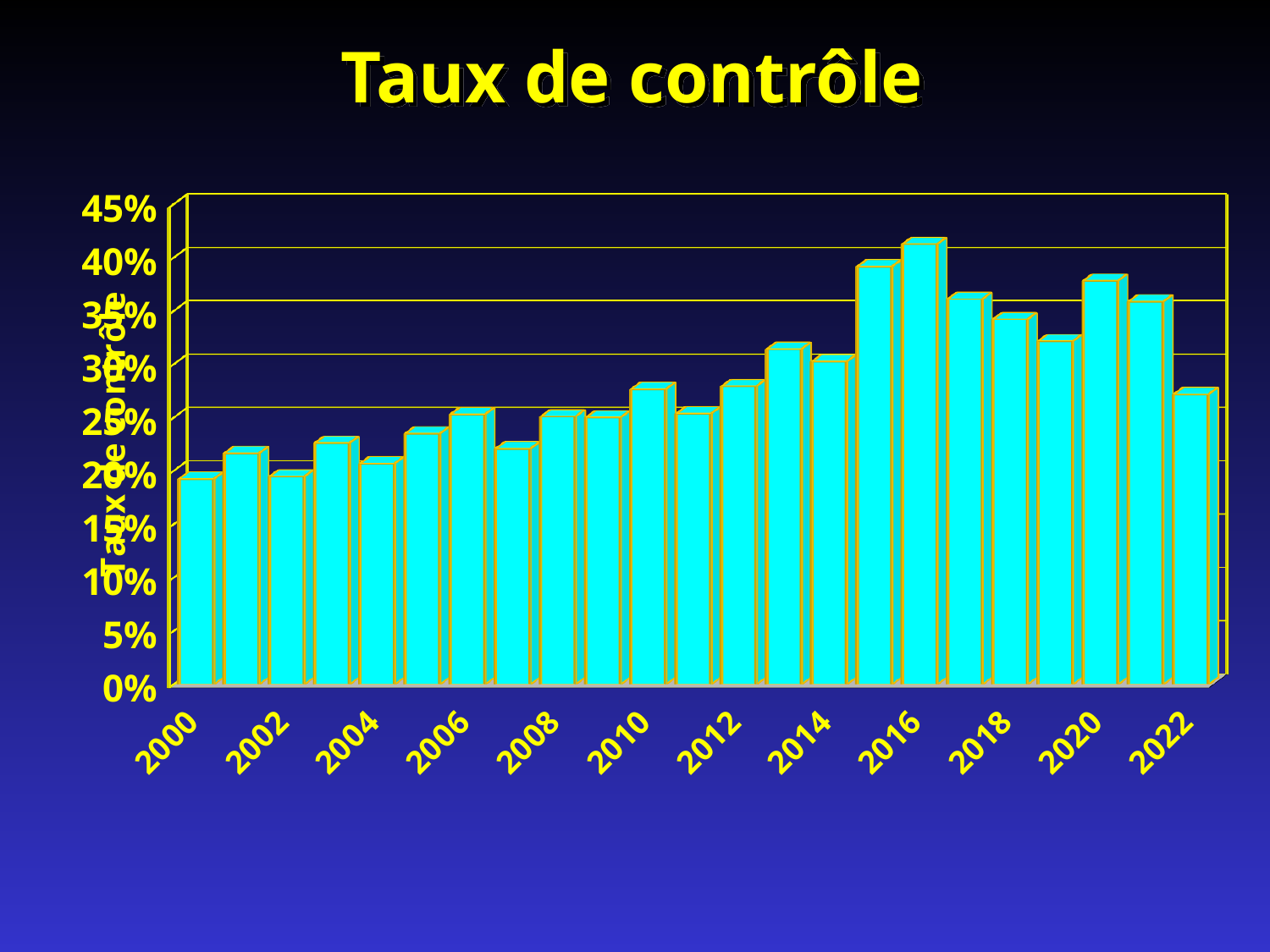
Is the value for 2022 greater or less than 25%? greater Is the value for 2015 greater or less than 35%? greater Which year has the larger value, 2019 or 2020? 2020 Is the value for 2000 greater or less than 25%? less Do the values generally rise or fall from 2000 to 2016? rise Which year has the larger value, 2014 or 2015? 2015 Which year has the highest taux de contrôle? 2016 How many years (bars) are plotted on the chart? 23 What kind of chart is shown on the slide? bar chart What is the title of the chart? Taux de contrôle